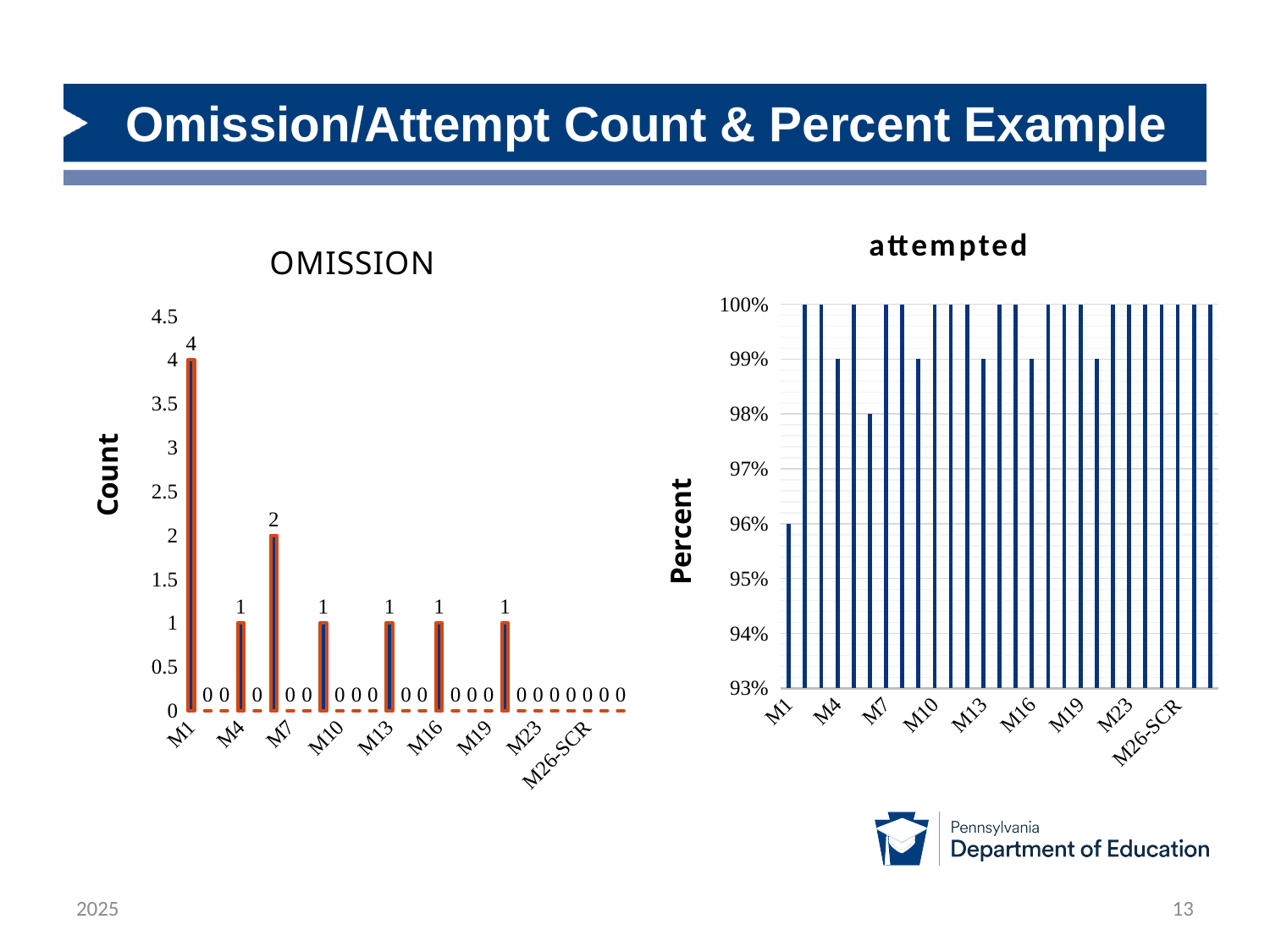
In the OMISSION chart, what is the count for M26-SCR? 0 In the OMISSION chart, what is the count for M1? 4 In the OMISSION chart, which category has the highest count? M1 In the attempted chart, is the value for M26-SCR greater or less than 99%? greater What kind of chart is the OMISSION chart? bar chart In the attempted chart, is the value for M1 greater or less than 97%? less In the OMISSION chart, what is the highest count shown? 4 What is the title of the chart on the right side of the slide? attempted In the attempted chart, which category has the lowest percent? M1 What is the y-axis title of the OMISSION chart? Count In the OMISSION chart, what is the difference between the count for M1 and the count for M26-SCR? 4 In the OMISSION chart, which is larger, the count for M1 or the count for M26-SCR? M1